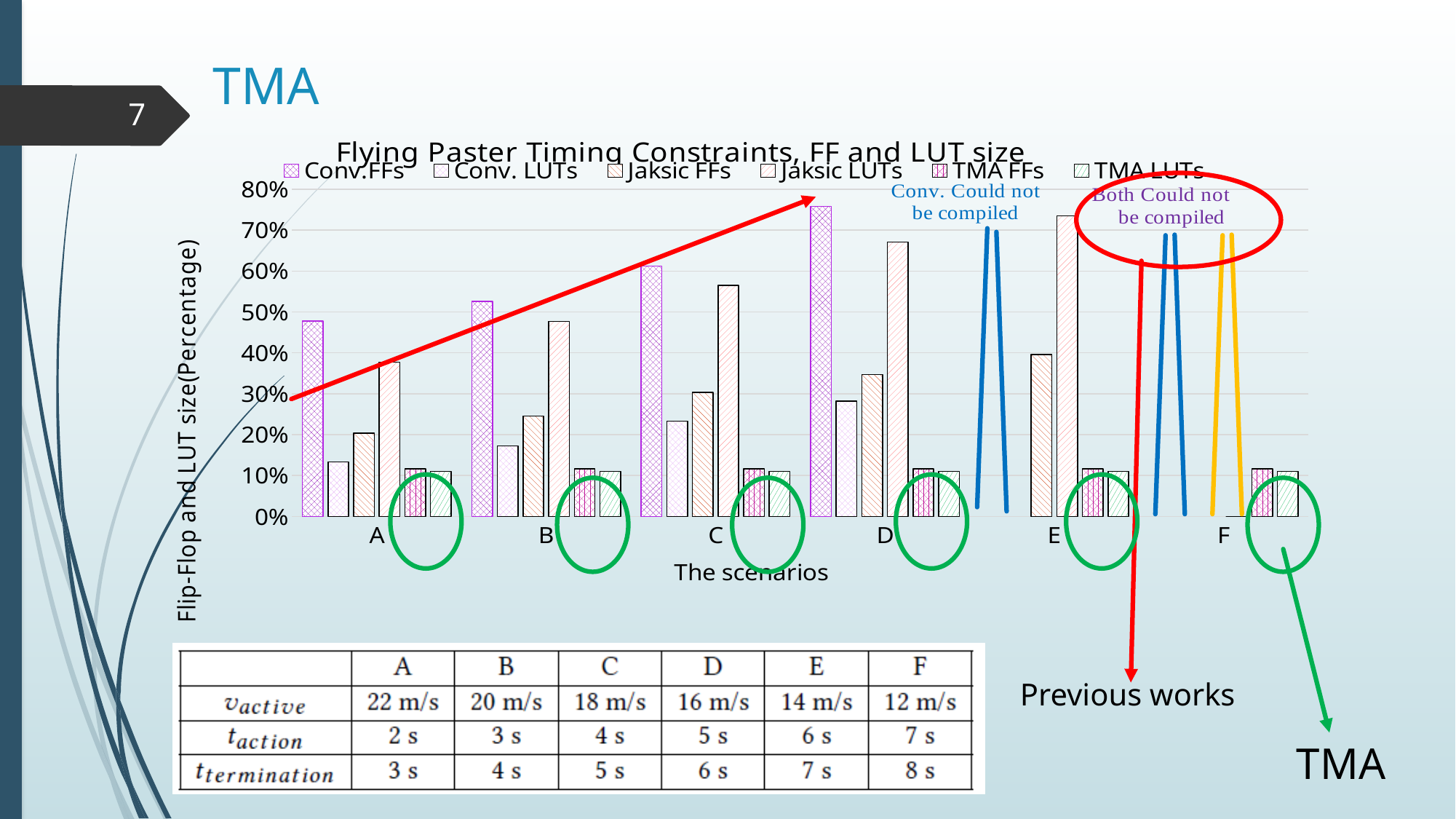
Is the Conv.FFs value for scenario D greater or less than 70%? greater Do the Conv.FFs values rise or fall from scenario A to scenario D? rise What kind of chart is shown on the slide? bar chart Is the TMA LUTs value for scenario A greater or less than 20%? less What is the title of the chart? Flying Paster Timing Constraints, FF and LUT size Which is larger for scenario A, Conv.FFs or Conv. LUTs? Conv.FFs How many scenario categories are shown on the x axis? 6 How many series does the chart legend list? 6 What is the label of the x axis? The scenarios Is the Jaksic LUTs value for scenario E greater or less than 70%? greater